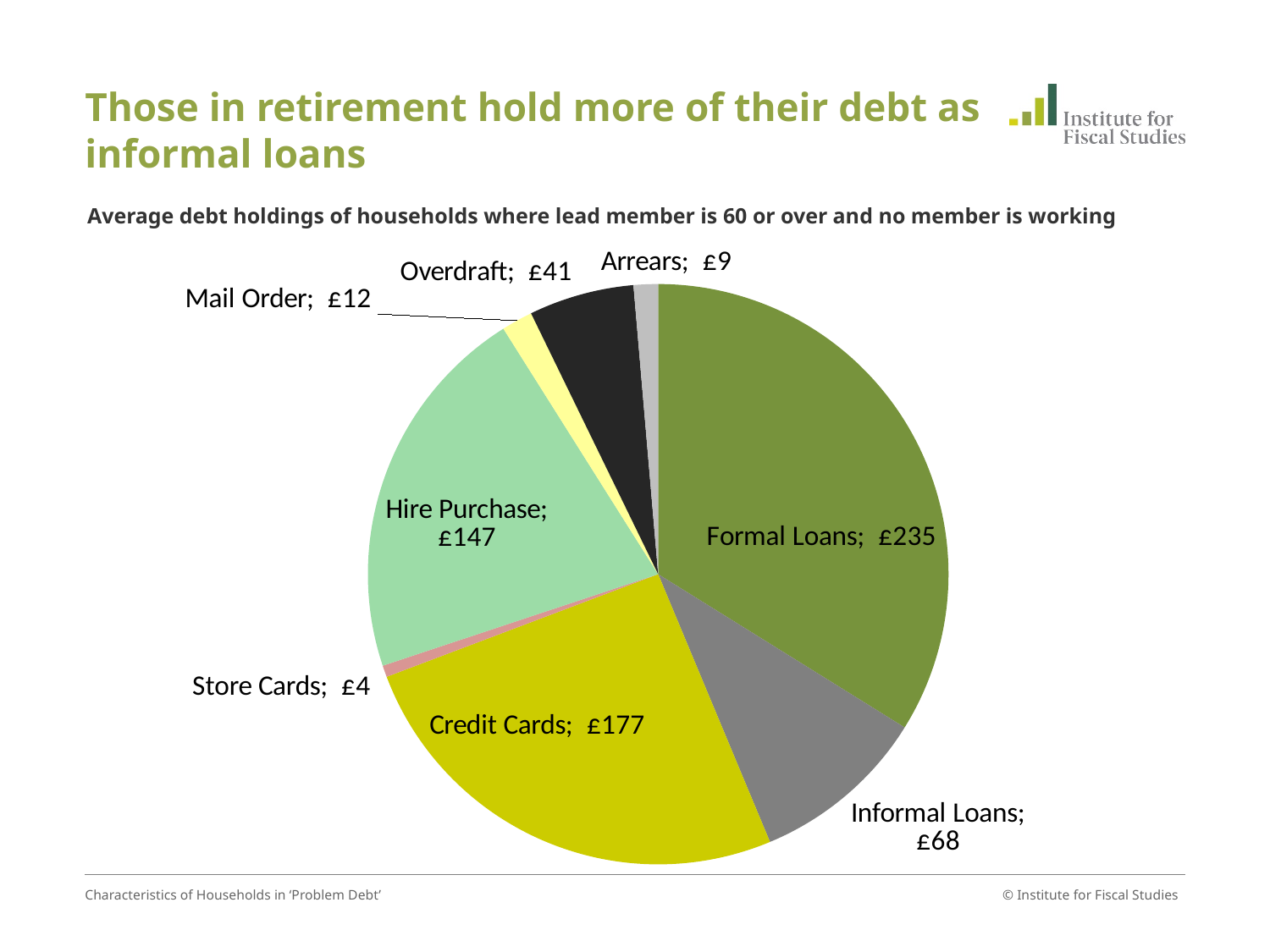
What is the average debt holding for Hire Purchase? £147 How many debt categories are shown in the pie chart? 8 Which debt category has the smallest slice of the pie? Store Cards Which debt category has the largest slice of the pie? Formal Loans What is the total of all the debt categories shown in the pie chart? £693 Which is larger, Credit Cards or Hire Purchase? Credit Cards What is the average debt holding for Informal Loans? £68 What is the difference between the Formal Loans and Credit Cards values? £58 What is the average debt holding for Formal Loans? £235 What is the difference between the Hire Purchase and Informal Loans values? £79 What is the average debt holding for Overdraft? £41 What kind of chart is shown on the slide? Pie chart